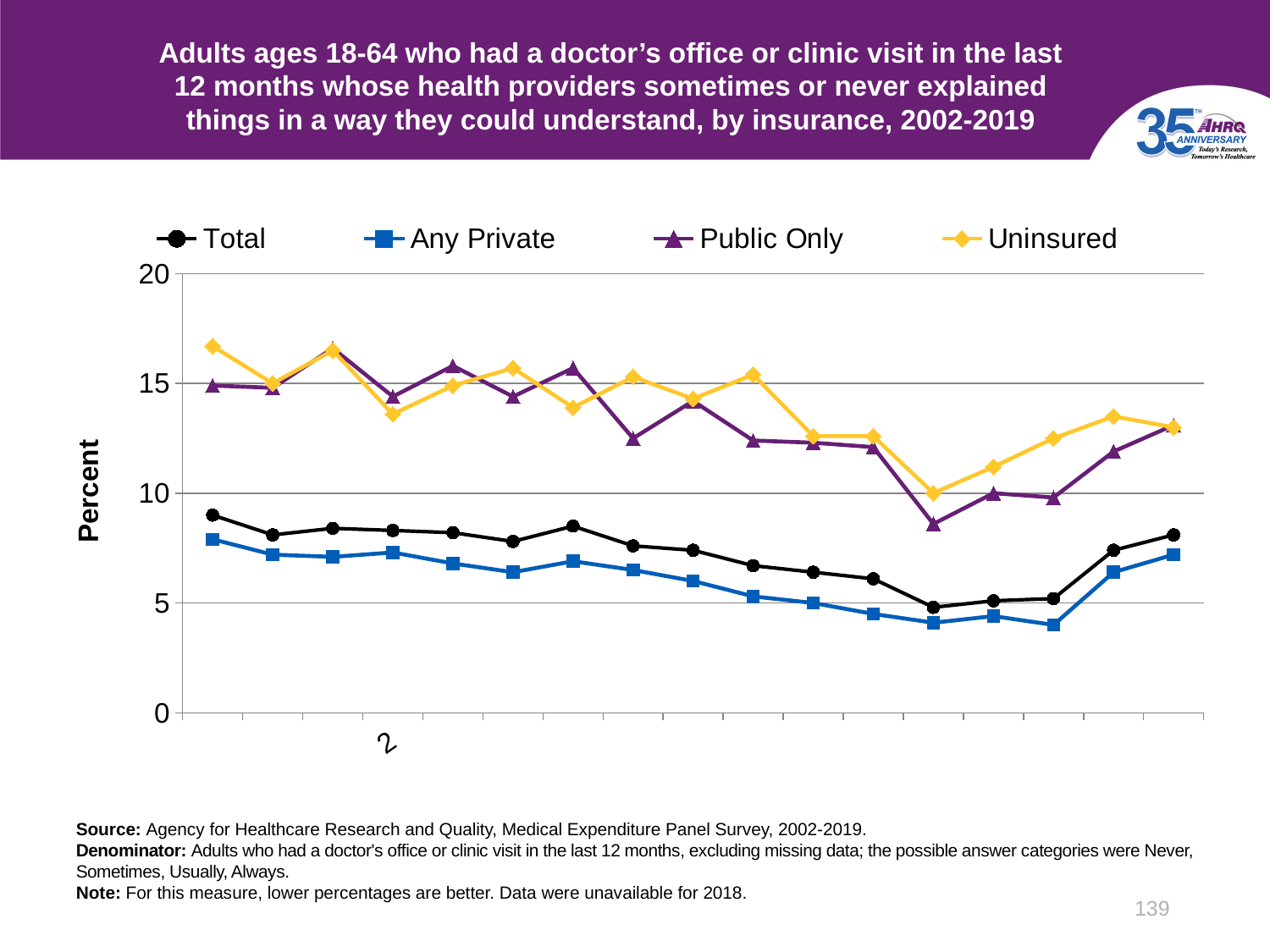
At the leftmost point, is the value for Uninsured greater or less than 15? greater How many series does the legend list? 4 What are the four series named in the legend? Total, Any Private, Public Only, Uninsured At the leftmost point, which series has the highest value? Uninsured Which series has the lowest values across the whole chart? Any Private What is the label on the vertical axis? Percent What kind of chart is shown on the slide? line chart At the rightmost point, is the value for Total greater or less than 10? less Does the Any Private series mostly rise or fall from the leftmost point to its lowest point? fall Is the lowest value of the Any Private series greater or less than 5? less At the leftmost point, which is larger, the value for Total or the value for Any Private? Total How many data points are plotted for the Total series? 17